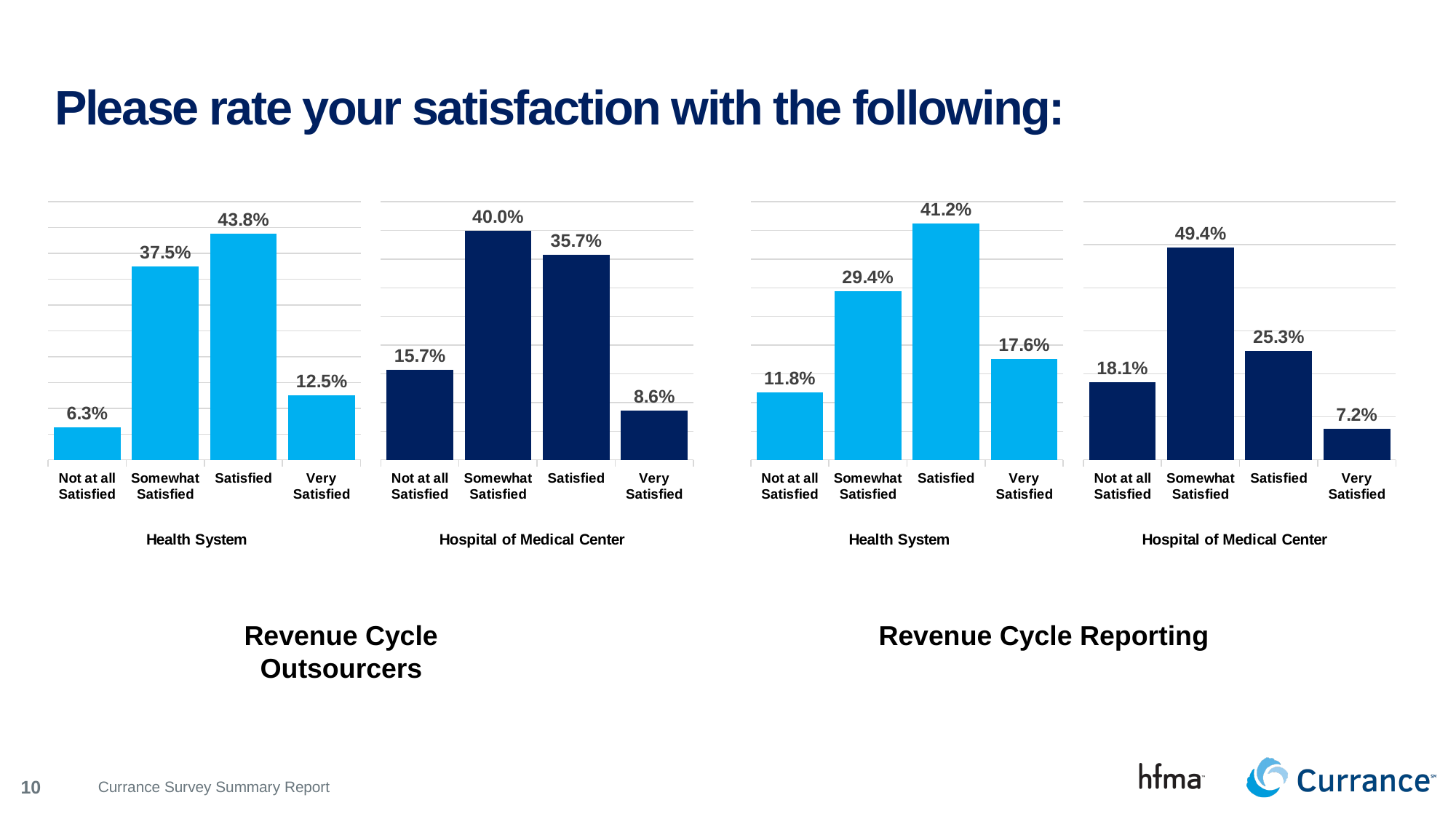
In the Revenue Cycle Outsourcers chart, which category has the lowest value for Health System? Not at all Satisfied How many satisfaction categories are shown for each group in the Revenue Cycle Reporting chart? 4 In the Revenue Cycle Reporting chart, what is the difference between the Satisfied values for Health System and Hospital of Medical Center? 15.9% In the Revenue Cycle Outsourcers chart, what is the difference between the Satisfied and Somewhat Satisfied values for Health System? 6.3% In the Revenue Cycle Reporting chart, what percentage of Health System respondents were Not at all Satisfied? 11.8% In the Revenue Cycle Outsourcers chart, what percentage of Hospital of Medical Center respondents were Somewhat Satisfied? 40.0% In the Revenue Cycle Outsourcers chart, which is larger: the Very Satisfied value for Health System or for Hospital of Medical Center? Health System In the Revenue Cycle Outsourcers chart, what percentage of Health System respondents were Satisfied? 43.8% In the Revenue Cycle Reporting chart, which category has the highest value for Hospital of Medical Center? Somewhat Satisfied In the Revenue Cycle Reporting chart, what percentage of Hospital of Medical Center respondents were Very Satisfied? 7.2% What type of chart is used for Revenue Cycle Outsourcers? Bar chart In the Revenue Cycle Reporting chart, what colour are the Hospital of Medical Center bars? Dark navy blue